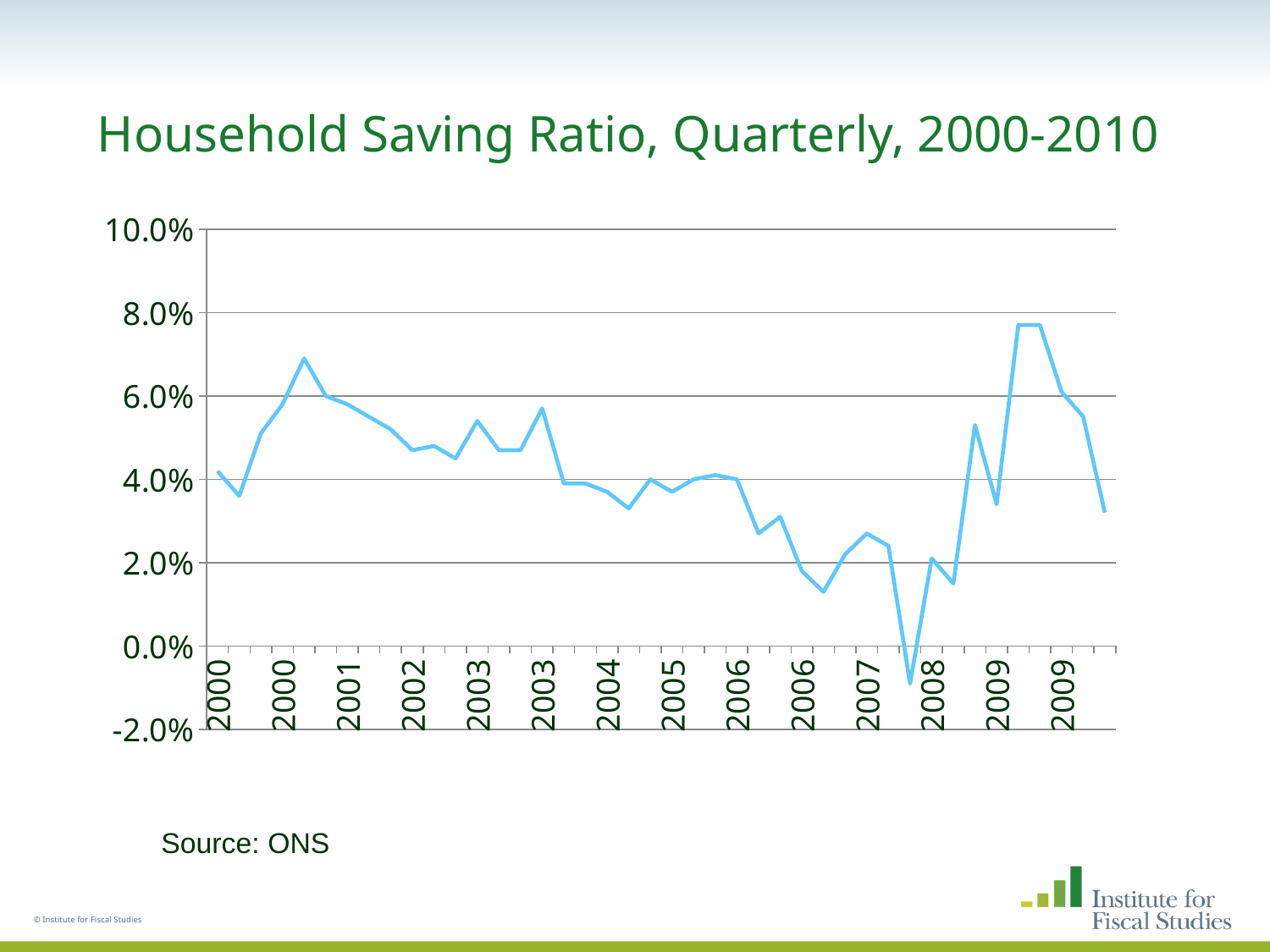
Is the first plotted value (at the start of 2000) greater or less than 6.0%? less What is the highest value shown on the y axis? 10.0% Which peak is higher: the peak around 2000 or the peak around 2009? the peak around 2009 Is the first plotted value (at the start of 2000) greater or less than 2.0%? greater Is the last plotted value at the right end of the line greater or less than 4.0%? less Does the saving ratio generally rise or fall between 2003 and 2006? fall What is the title of the chart? Household Saving Ratio, Quarterly, 2000-2010 What source is cited for the chart data? ONS What kind of chart is shown on the slide? line chart